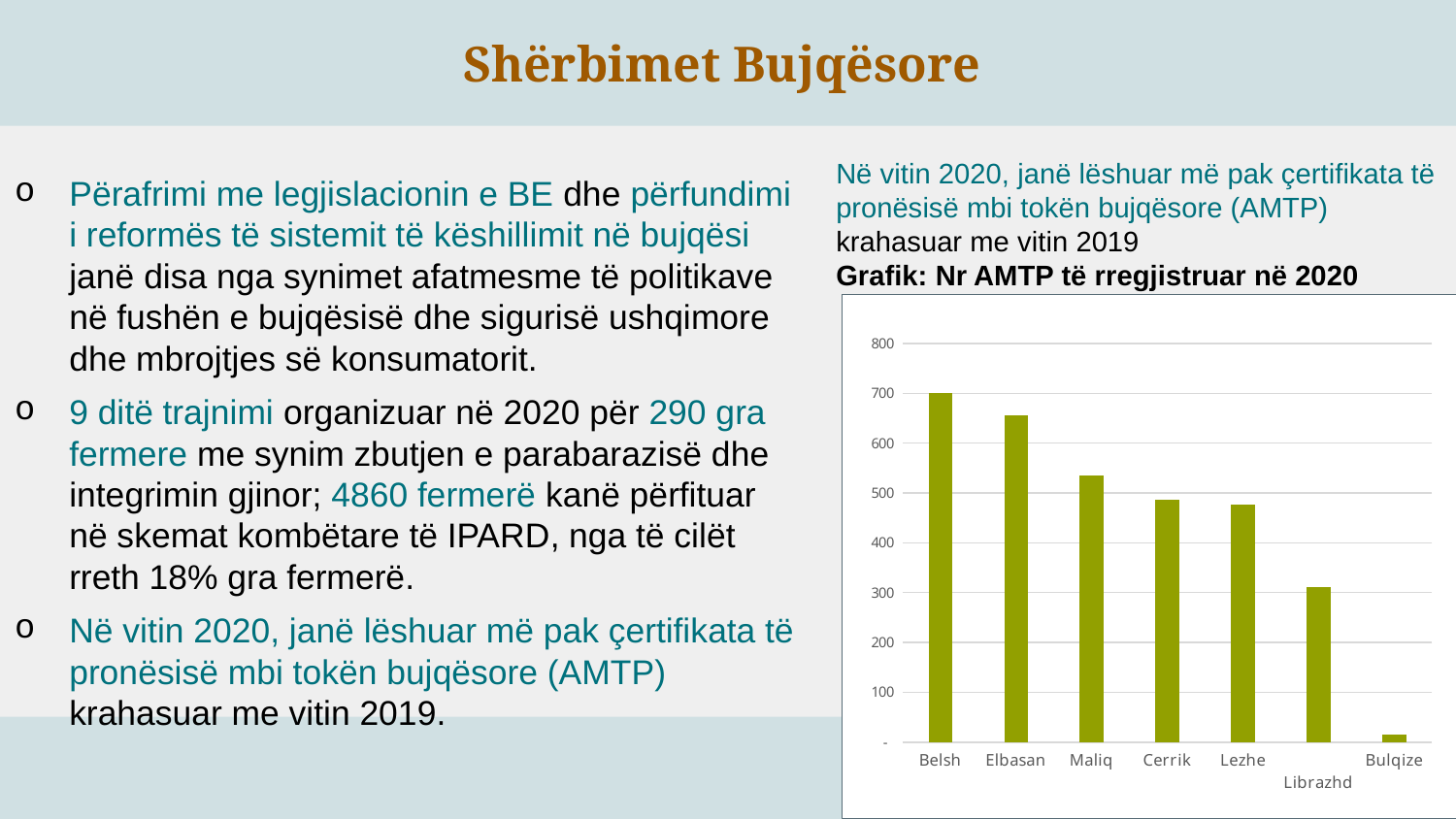
Which is larger, the value for Elbasan or the value for Maliq? Elbasan Which category has the lowest value in the chart? Bulqize What kind of chart is shown on the slide? bar chart What is the title of the chart? Grafik: Nr AMTP të rregjistruar në 2020 How many categories are shown on the x axis of the chart? 7 Is the value for Bulqize greater or less than 100? less Is the value for Cerrik greater or less than 600? less Is the value for Maliq greater or less than 500? greater Do the values generally rise or fall from left to right along the x axis? fall Which category has the highest value in the chart? Belsh